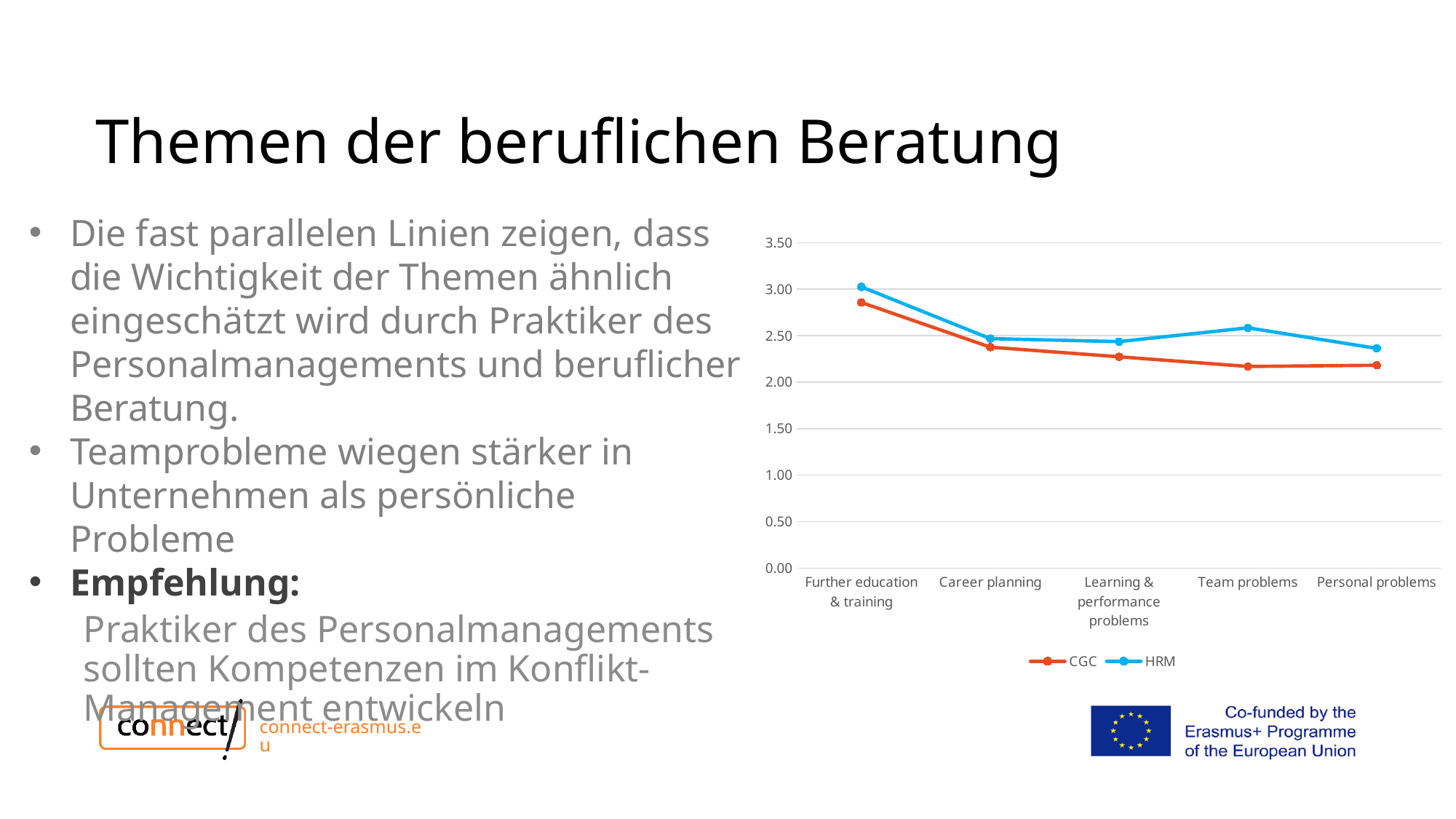
For Team problems, which series has the larger value, CGC or HRM? HRM How many series does the chart's legend list? 2 What kind of chart is shown on the slide? line chart Is the HRM value for Personal problems greater or less than 3.00? less Which series is drawn in blue in the chart? HRM Is the CGC value for Team problems greater or less than 2.50? less Is the CGC value for Further education & training greater or less than 2.50? greater How many categories are plotted along the x axis of the chart? 5 For which category is the HRM value highest? Further education & training Does the CGC line rise or fall from Further education & training to Team problems? fall For which category is the CGC value highest? Further education & training